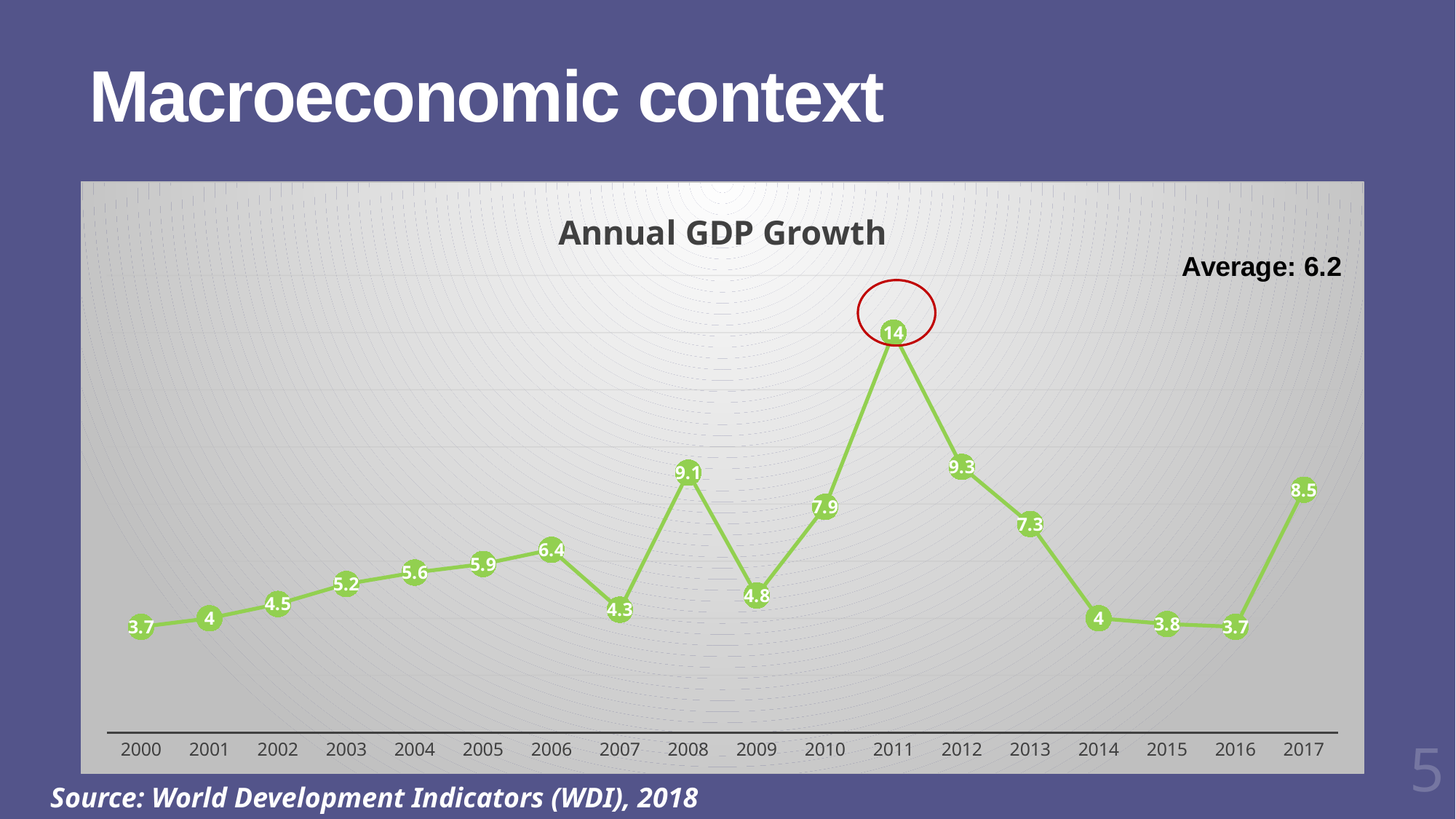
What is the difference between the GDP growth values for 2016 and 2017? 4.8 What is the annual GDP growth value for 2008? 9.1 What is the annual GDP growth value for 2017? 8.5 What is the difference between the GDP growth values for 2011 and 2012? 4.7 Which year has the highest annual GDP growth? 2011 Do the GDP growth values rise or fall from 2000 to 2006? Rise What is the annual GDP growth value for 2011? 14 What average value is printed on the chart? 6.2 What kind of chart is shown on the slide? Line chart What is the title of the chart? Annual GDP Growth Which year has a higher GDP growth value, 2008 or 2010? 2008 How many years are plotted on the x axis? 18